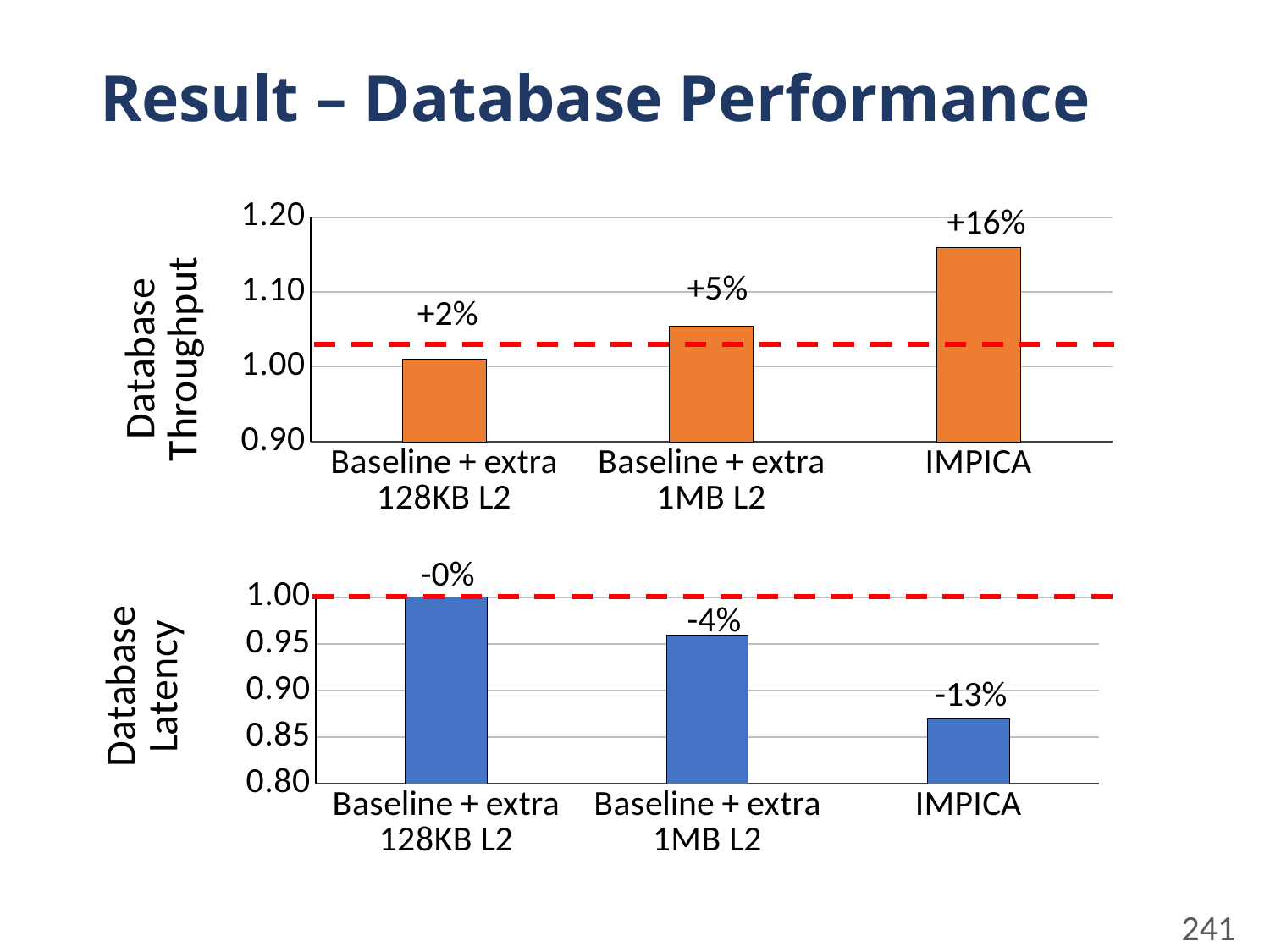
On the Database Throughput chart, is the value for IMPICA greater or less than 1.10? greater On the Database Throughput chart, which category has the highest bar? IMPICA On the Database Latency chart, which category has the lowest bar? IMPICA On the Database Throughput chart, what is the data label for IMPICA? +16% What colour are the bars on the Database Latency chart? Blue On the Database Latency chart, what is the data label for Baseline + extra 1MB L2? -4% On the Database Throughput chart, which bar is taller: Baseline + extra 128KB L2 or Baseline + extra 1MB L2? Baseline + extra 1MB L2 On the Database Throughput chart, what is the data label for Baseline + extra 1MB L2? +5% What type of chart is the Database Throughput chart? Bar chart On the Database Latency chart, is the value for IMPICA greater or less than 0.90? less On the Database Latency chart, what is the data label for IMPICA? -13% How many categories are shown on the Database Latency chart? 3